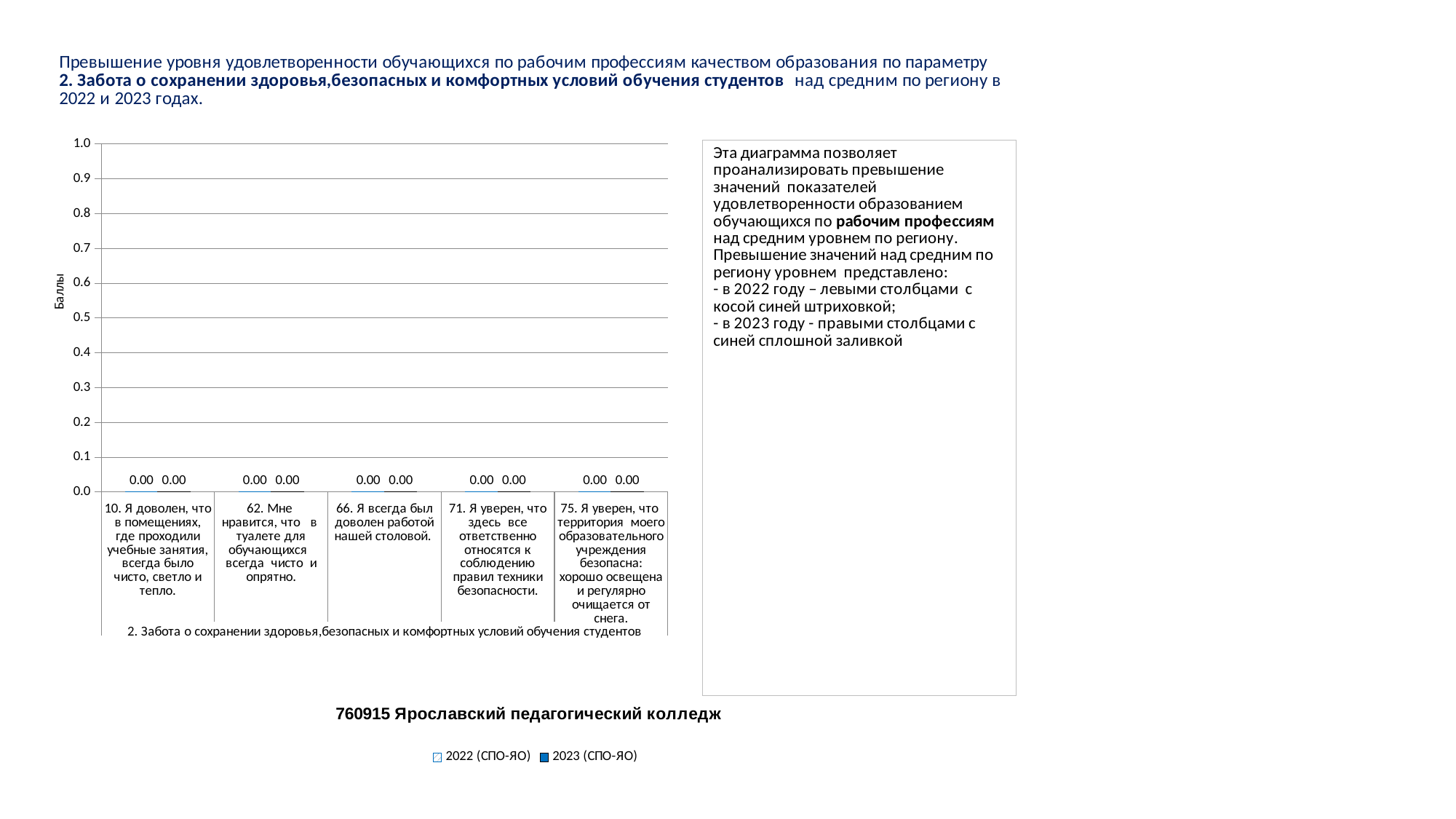
What is the label of the vertical axis of the chart? Баллы What is the value for 2023 (СПО-ЯО) for category "10. Я доволен, что в помещениях, где проходили учебные занятия, всегда было чисто, светло и тепло."? 0.00 What is the difference between the 2022 (СПО-ЯО) and 2023 (СПО-ЯО) values for category "62. Мне нравится, что в туалете для обучающихся всегда чисто и опрятно."? 0.00 What is the value for 2022 (СПО-ЯО) for category "66. Я всегда был доволен работой нашей столовой."? 0.00 Is the value for 2023 (СПО-ЯО) for category "66. Я всегда был доволен работой нашей столовой." greater or less than 0.5? less What is the value for 2022 (СПО-ЯО) for category "71. Я уверен, что здесь все ответственно относятся к соблюдению правил техники безопасности."? 0.00 How many series does the chart legend list? 2 What type of chart is shown on the slide? bar chart What is the value for 2023 (СПО-ЯО) for category "75. Я уверен, что территория моего образовательного учреждения безопасна: хорошо освещена и регулярно очищается от снега."? 0.00 How many categories are shown on the x axis of the chart? 5 What are the two legend entries of the chart? 2022 (СПО-ЯО) and 2023 (СПО-ЯО)